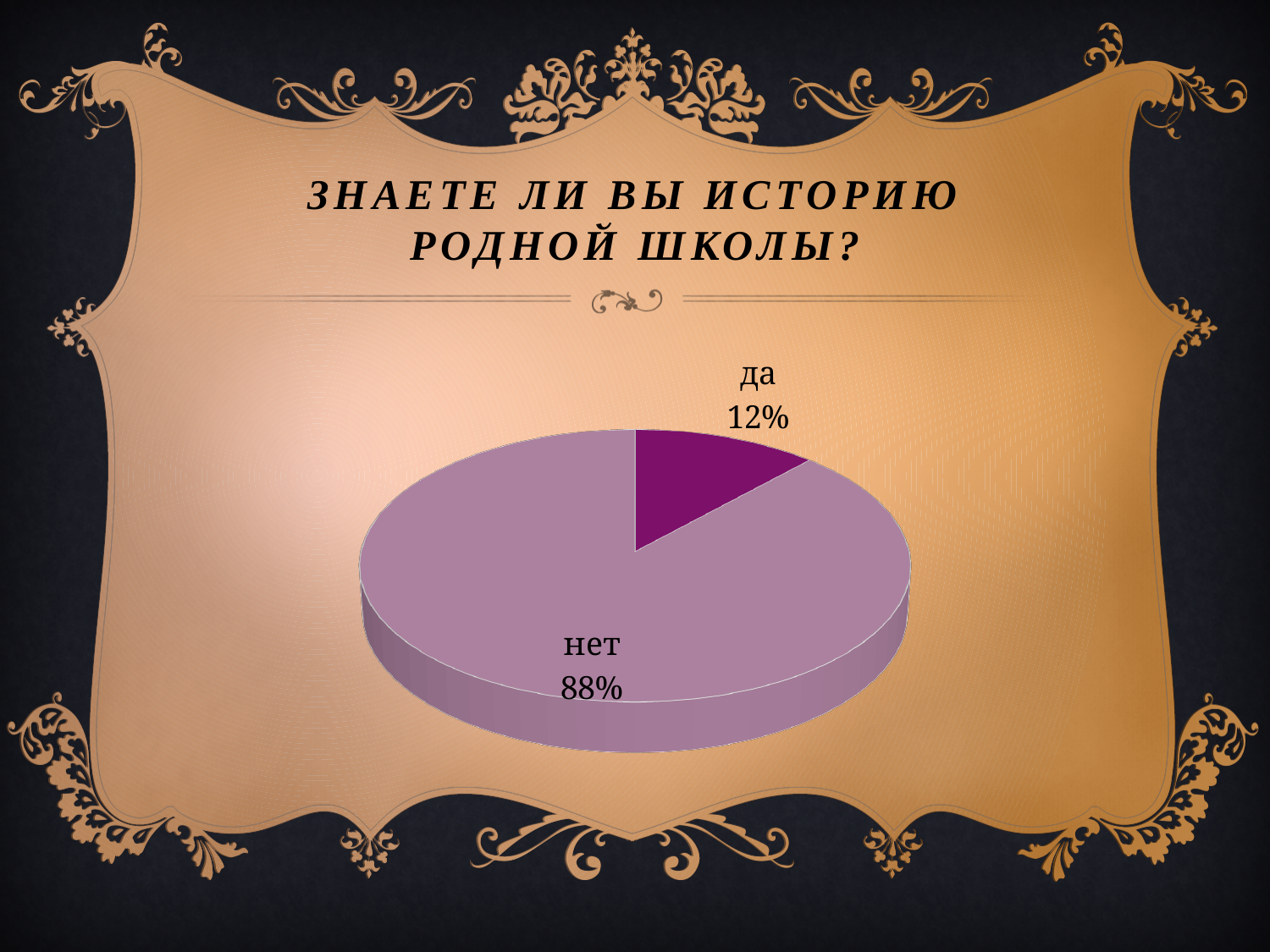
Which is larger, the "да" slice or the "нет" slice? нет What share of the pie does the "нет" slice represent? 88% How many slices does the pie chart have? 2 Which slice of the pie is the largest? нет What colour is the "да" slice of the pie chart? dark purple What share of the pie does the "да" slice represent? 12% What kind of chart is shown on the slide? pie chart Which slice of the pie is the smallest? да What is the title of the slide containing the pie chart? Знаете ли вы историю родной школы? What is the difference in percentage points between the "нет" and "да" slices? 76